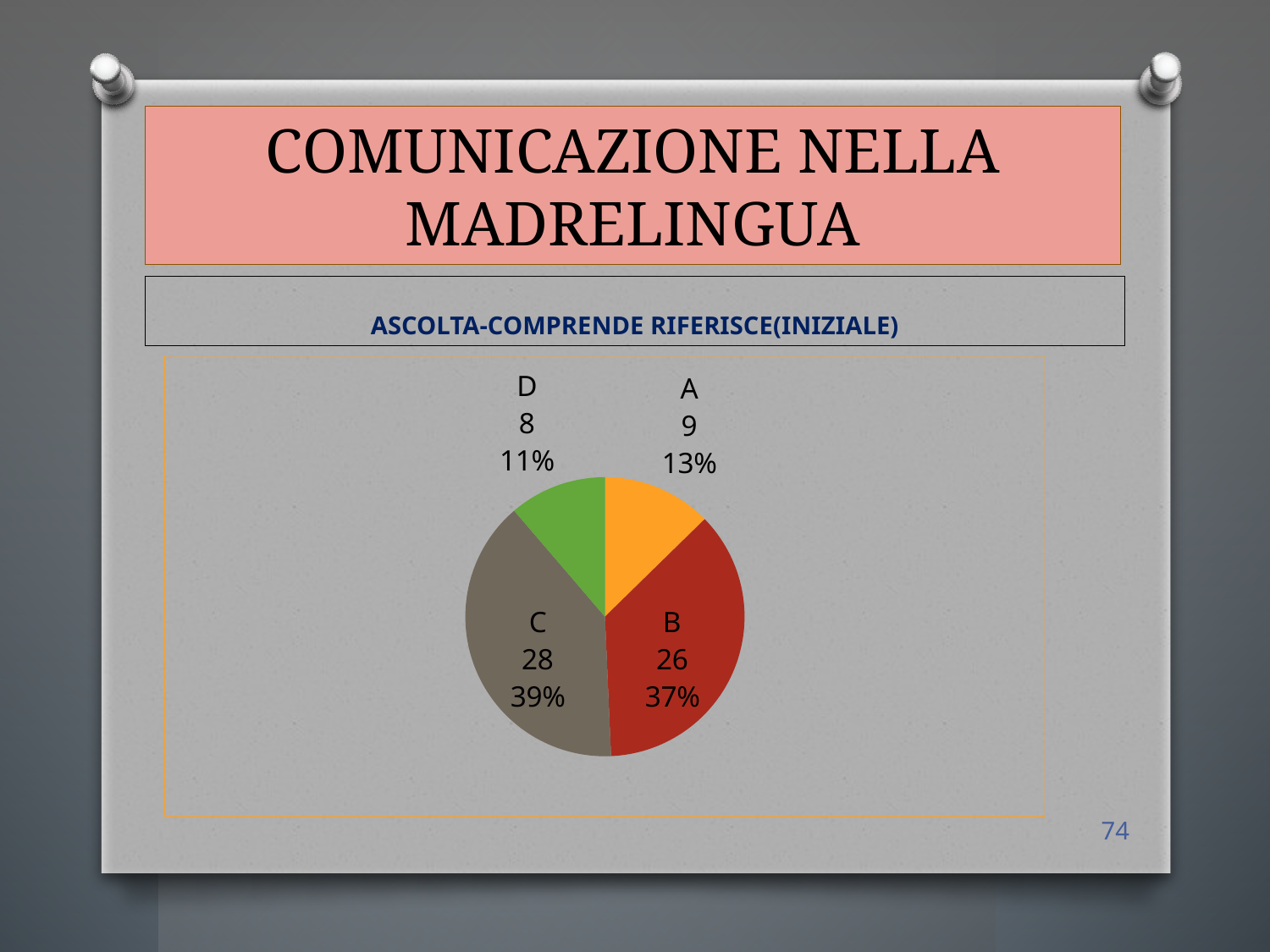
What is the value for category C? 28 How many categories does the pie chart have? 4 Which category has the smallest slice? D Which is larger, the value for A or the value for D? A What is the difference between the values for A and D? 1 What is the value for category A? 9 Which category has the largest slice? C What percentage share does category D have? 11% What percentage share does category B have? 37% What is the total of all the values in the pie chart? 71 What kind of chart is shown on the slide? pie chart What is the difference between the values for C and B? 2